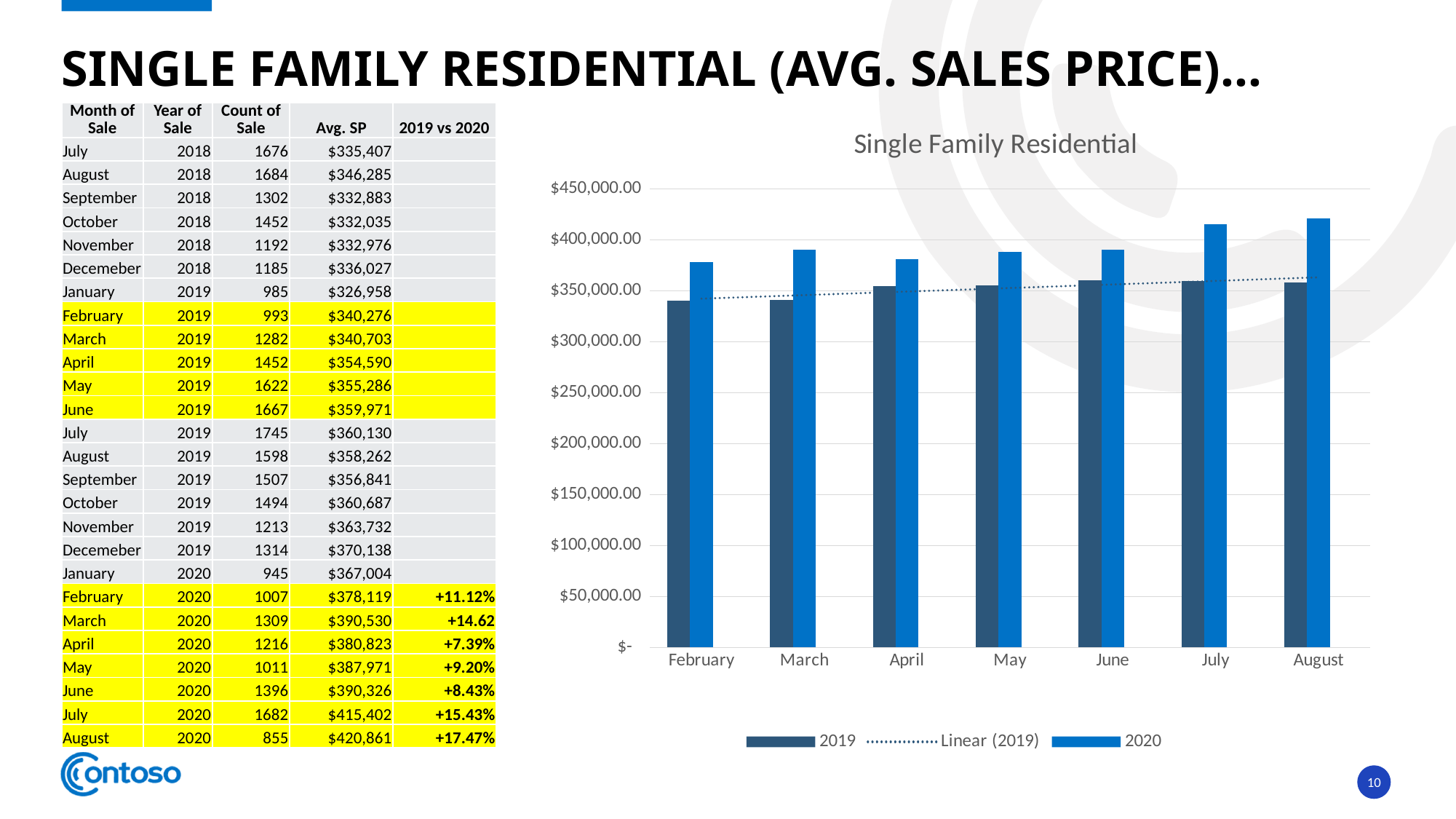
In the chart, is the 2019 bar for June greater or less than $350,000.00? greater How many months are shown on the x axis of the chart? 7 Does the dotted Linear (2019) trend line rise or fall from February to August? Rise What kind of chart is shown on the slide? Bar chart How many entries does the chart legend list? 3 In the chart, is the 2020 bar for August greater or less than $400,000.00? greater Which month has the highest 2020 bar in the chart? August In the chart, which is larger for July: the 2019 bar or the 2020 bar? 2020 Which month has the lowest 2020 bar in the chart? February In the chart, is the 2019 bar for February greater or less than $350,000.00? less What is the title of the chart? Single Family Residential